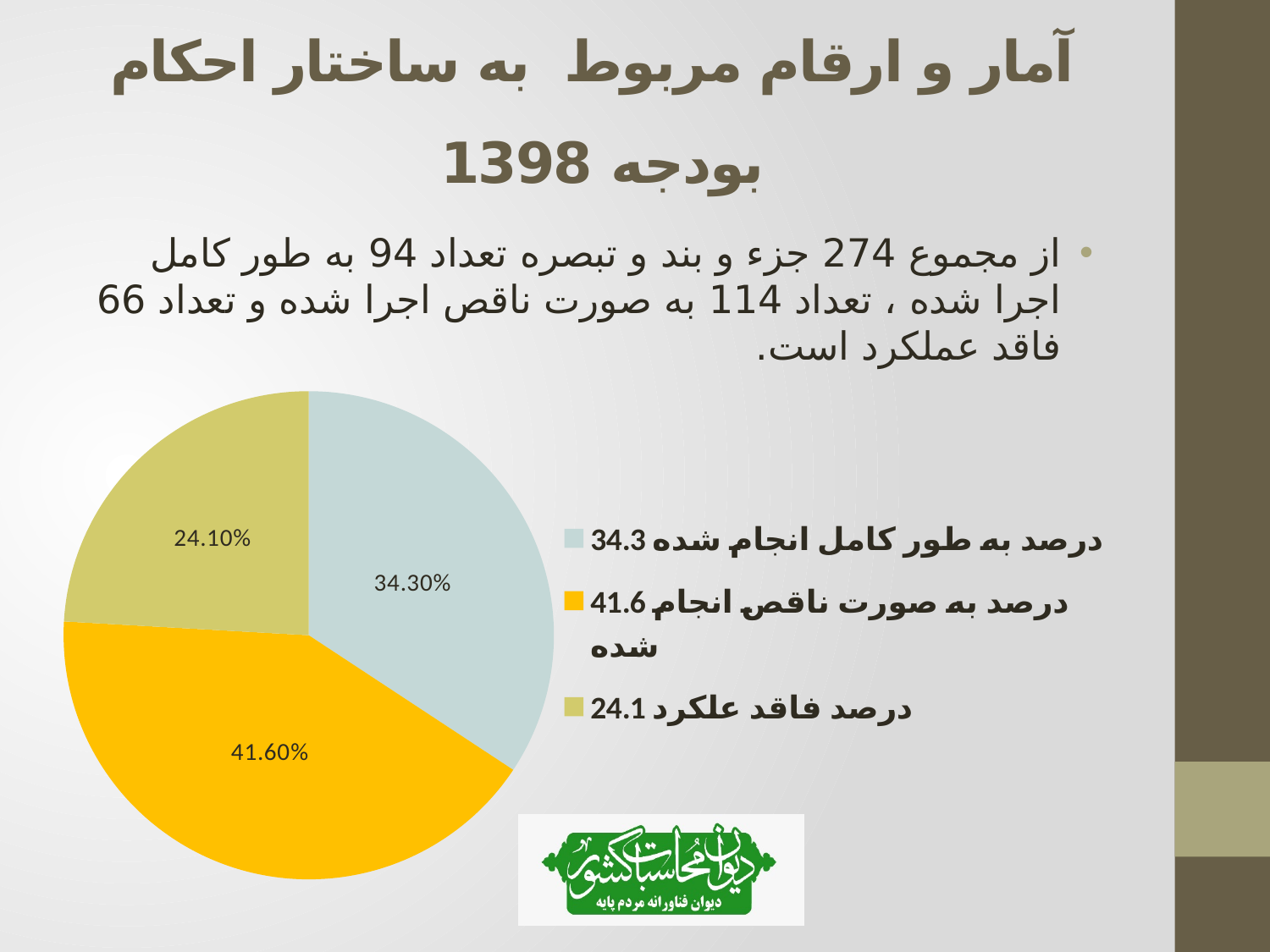
What colour is the slice labelled 41.60%? yellow What is the data label on the slice for "درصد به صورت ناقص انجام شده"? 41.60% How many entries does the legend of the pie chart list? 3 Which is larger: the slice for "درصد به طور کامل انجام شده" or the slice for "درصد فاقد علکرد"? درصد به طور کامل انجام شده Which slice of the pie chart is the smallest? درصد فاقد علکرد What value does the legend show next to "درصد فاقد علکرد"? 24.1 What kind of chart is shown on the slide? pie chart What is the difference between the 41.60% slice and the 34.30% slice? 7.30% What is the data label on the slice for "درصد به طور کامل انجام شده"? 34.30% What is the data label on the slice for "درصد فاقد علکرد"? 24.10% Which slice of the pie chart is the largest? درصد به صورت ناقص انجام شده How many slices does the pie chart have? 3